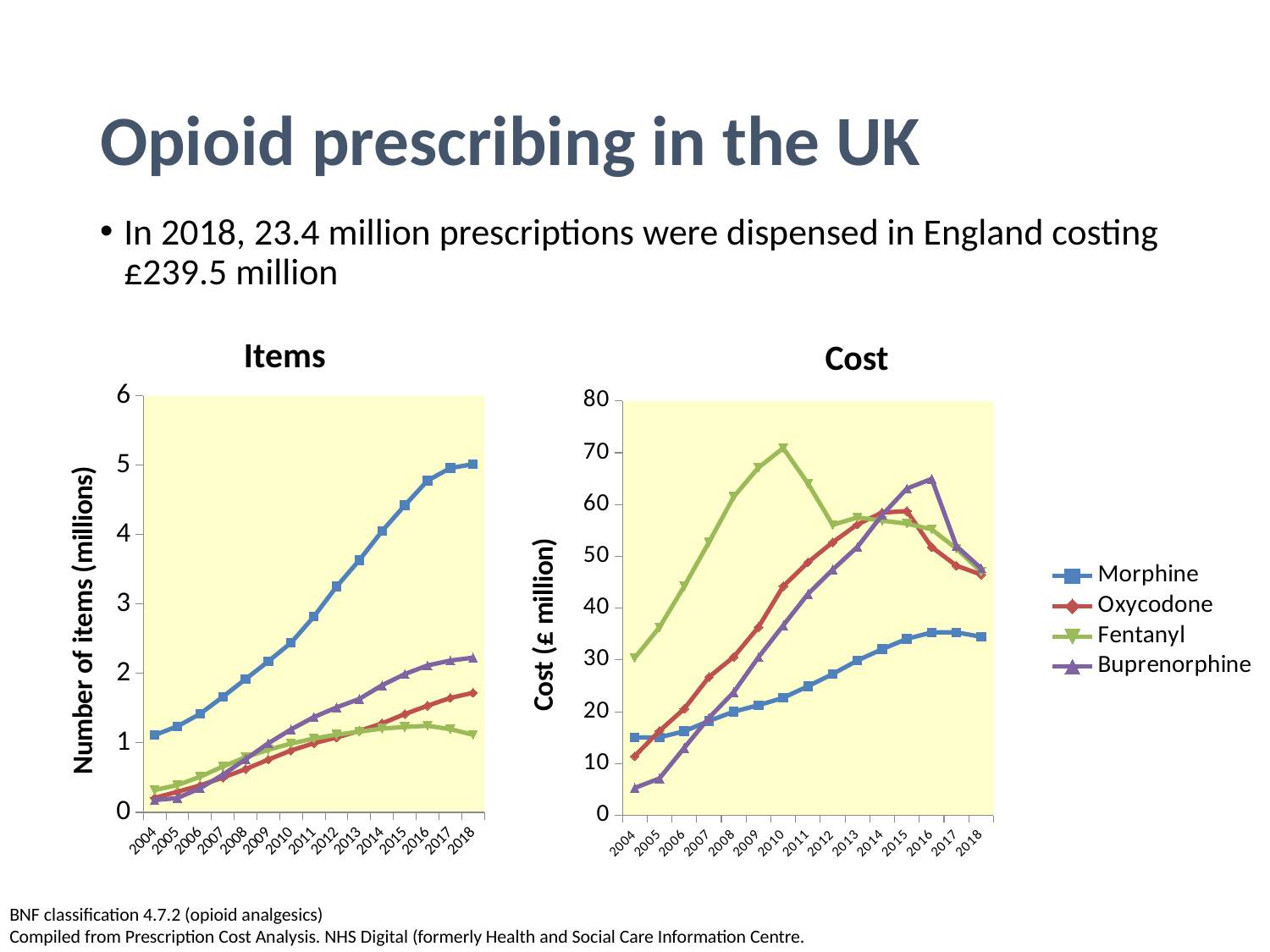
What kind of chart is the Items chart? line chart In the Items chart, which series has the highest value in 2018? Morphine In the Items chart, does the Morphine series rise or fall from 2004 to 2018? rise What is the y-axis label of the Cost chart? Cost (£ million) In the Cost chart, is the value for Fentanyl in 2010 greater or less than 60? greater How many years are plotted on the x axis of the Cost chart? 15 In the Cost chart, which is larger in 2018, Morphine or Buprenorphine? Buprenorphine In the Items chart, is the value for Morphine in 2012 greater or less than 3? greater How many series does the legend list? 4 In the Items chart, which series has the lowest value in 2018? Fentanyl In the Cost chart, which series has the lowest value in 2004? Buprenorphine In the Cost chart, which series reaches the highest peak value? Fentanyl